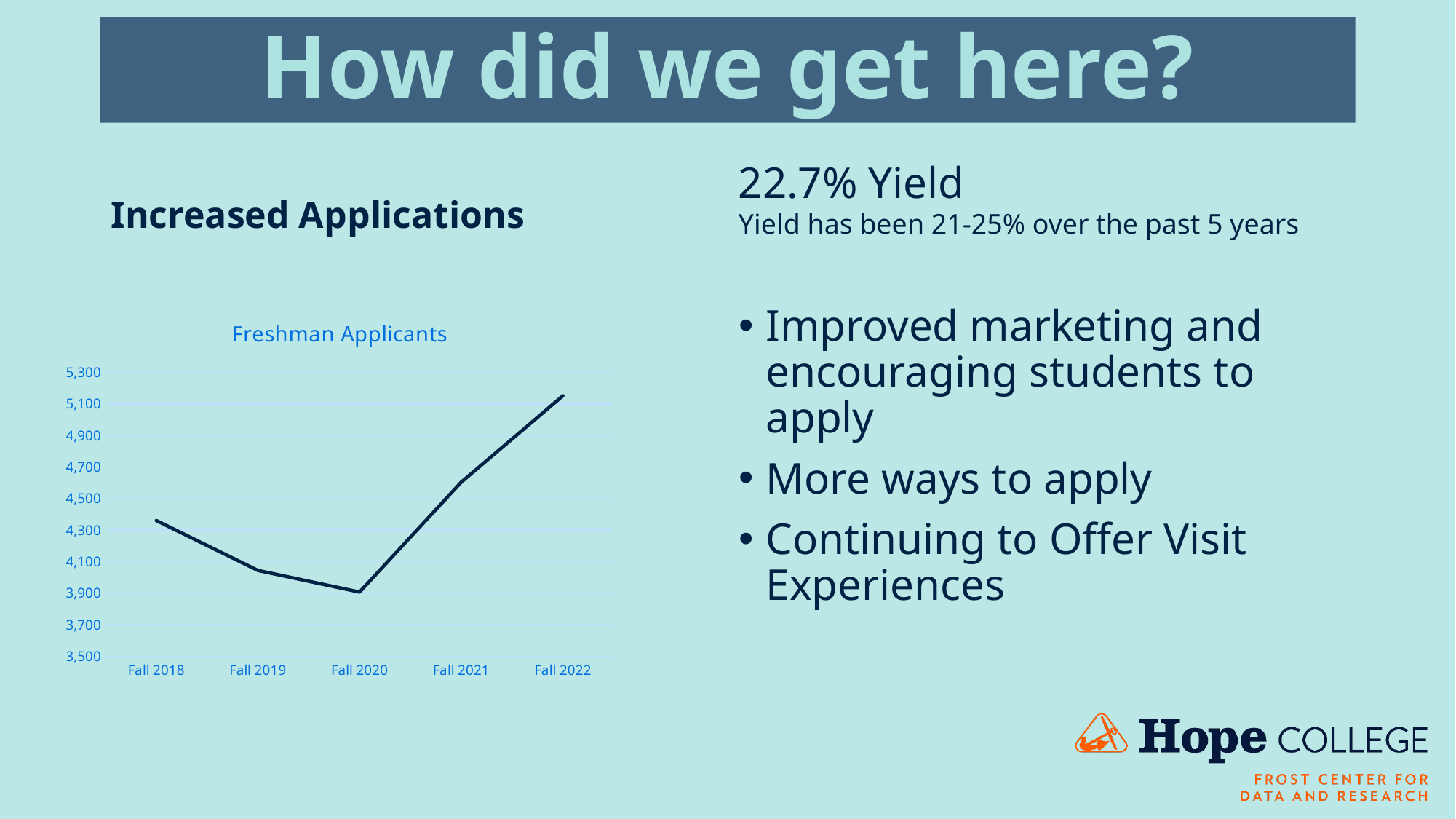
Is the value for Fall 2021 greater or less than 4,500? greater Is the value for Fall 2022 greater or less than 5,100? greater Which term has the highest number of freshman applicants? Fall 2022 What is the title of the chart? Freshman Applicants Which is larger, the value for Fall 2018 or the value for Fall 2019? Fall 2018 What kind of chart is shown on the slide? line chart What is the first x-axis label on the chart? Fall 2018 How many points are plotted on the Freshman Applicants line? 5 Which term has the lowest number of freshman applicants? Fall 2020 Is the value for Fall 2020 greater or less than 4,100? less Do freshman applicants rise or fall from Fall 2020 to Fall 2022? rise